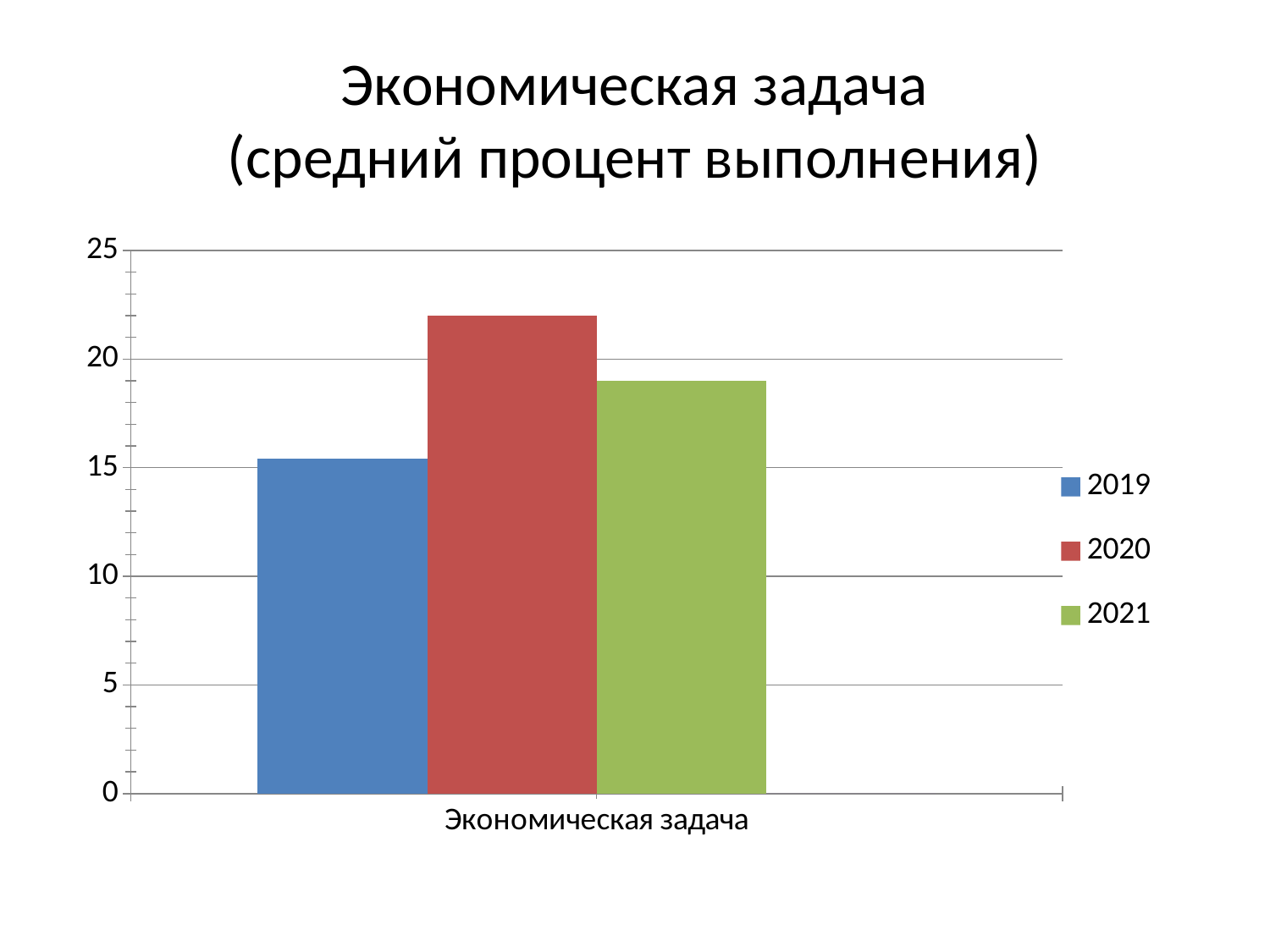
Which is larger, the value for 2019 or the value for 2021? 2021 Which year has the highest value for Экономическая задача? 2020 Is the value for 2020 greater or less than 20? greater What kind of chart is shown on the slide? bar chart Which is larger, the value for 2020 or the value for 2021? 2020 Is the value for 2019 greater or less than 20? less Which year has the lowest value for Экономическая задача? 2019 Which colour represents the 2021 series in the legend? green How many categories are shown on the x axis? 1 How many series does the legend list? 3 What is the title of the chart on the slide? Экономическая задача (средний процент выполнения) Is the value for 2021 greater or less than 15? greater